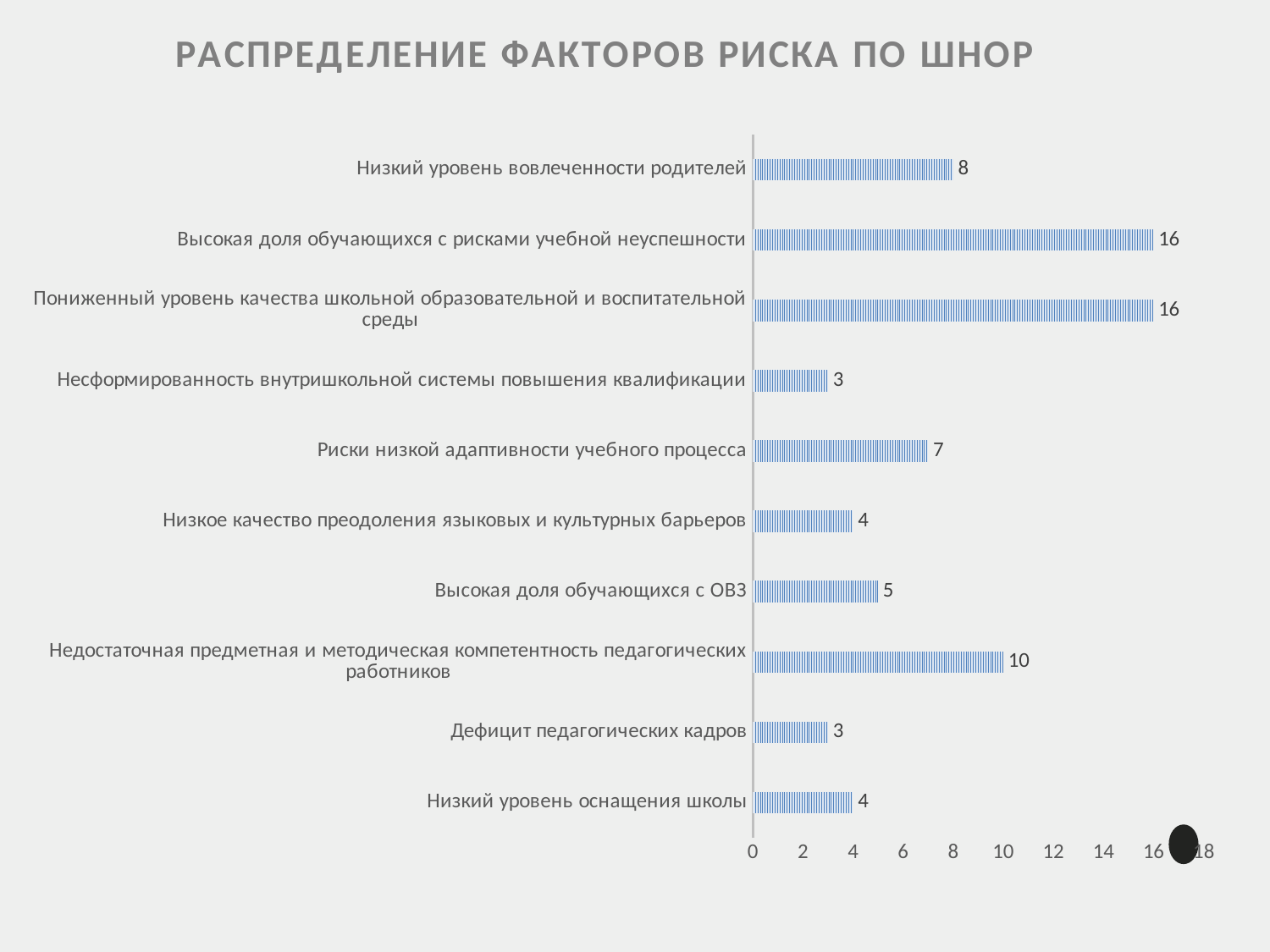
Which is larger: the value for "Недостаточная предметная и методическая компетентность педагогических работников" or the value for "Риски низкой адаптивности учебного процесса"? Недостаточная предметная и методическая компетентность педагогических работников What type of chart is shown on the slide? bar chart What is the title of the chart? РАСПРЕДЕЛЕНИЕ ФАКТОРОВ РИСКА ПО ШНОР What is the value for "Недостаточная предметная и методическая компетентность педагогических работников"? 10 What is the value for "Дефицит педагогических кадров"? 3 What is the difference between the values for "Высокая доля обучающихся с ОВЗ" and "Низкий уровень оснащения школы"? 1 How many categories are shown in the chart? 10 What is the highest value shown in the chart? 16 What is the value for "Высокая доля обучающихся с ОВЗ"? 5 What is the value for "Риски низкой адаптивности учебного процесса"? 7 What is the value for "Низкий уровень вовлеченности родителей"? 8 What is the difference between the values for "Высокая доля обучающихся с рисками учебной неуспешности" and "Низкий уровень вовлеченности родителей"? 8